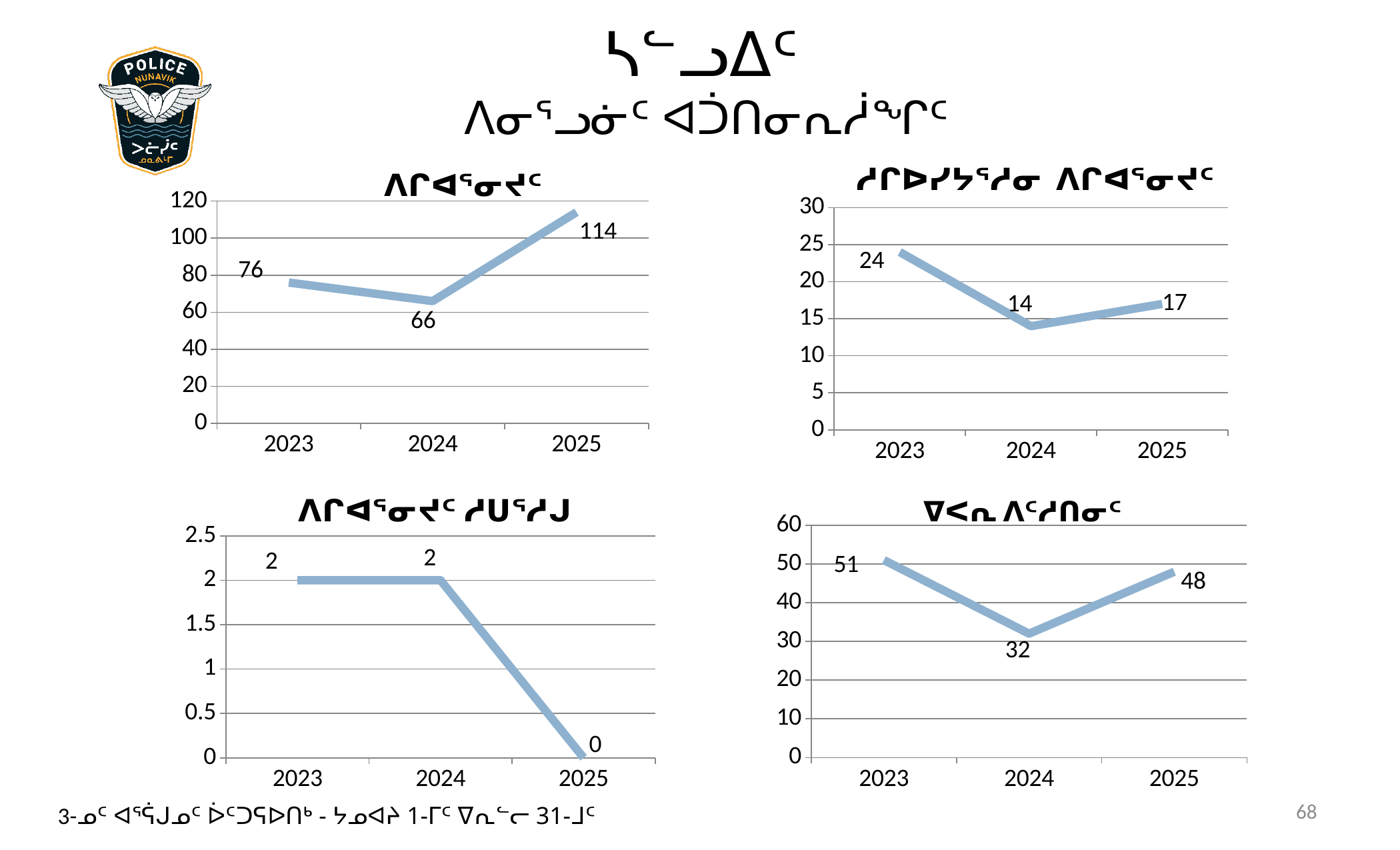
In the top-left chart, what is the value for 2025? 114 In the top-right chart, is the value for 2024 larger or smaller than the value for 2025? smaller What type of chart is the top-left chart? line chart How many data points are plotted in the bottom-right chart? 3 In the bottom-right chart, what is the value for 2024? 32 In the bottom-right chart, what is the difference between the 2023 and 2024 values? 19 In the top-left chart, what is the difference between the 2025 and 2023 values? 38 In the top-left chart, which year has the lowest value? 2024 In the top-right chart, what is the value for 2023? 24 In the bottom-left chart, does the value rise or fall from 2024 to 2025? fall In the bottom-left chart, what is the value for 2025? 0 In the top-right chart, which year has the highest value? 2023